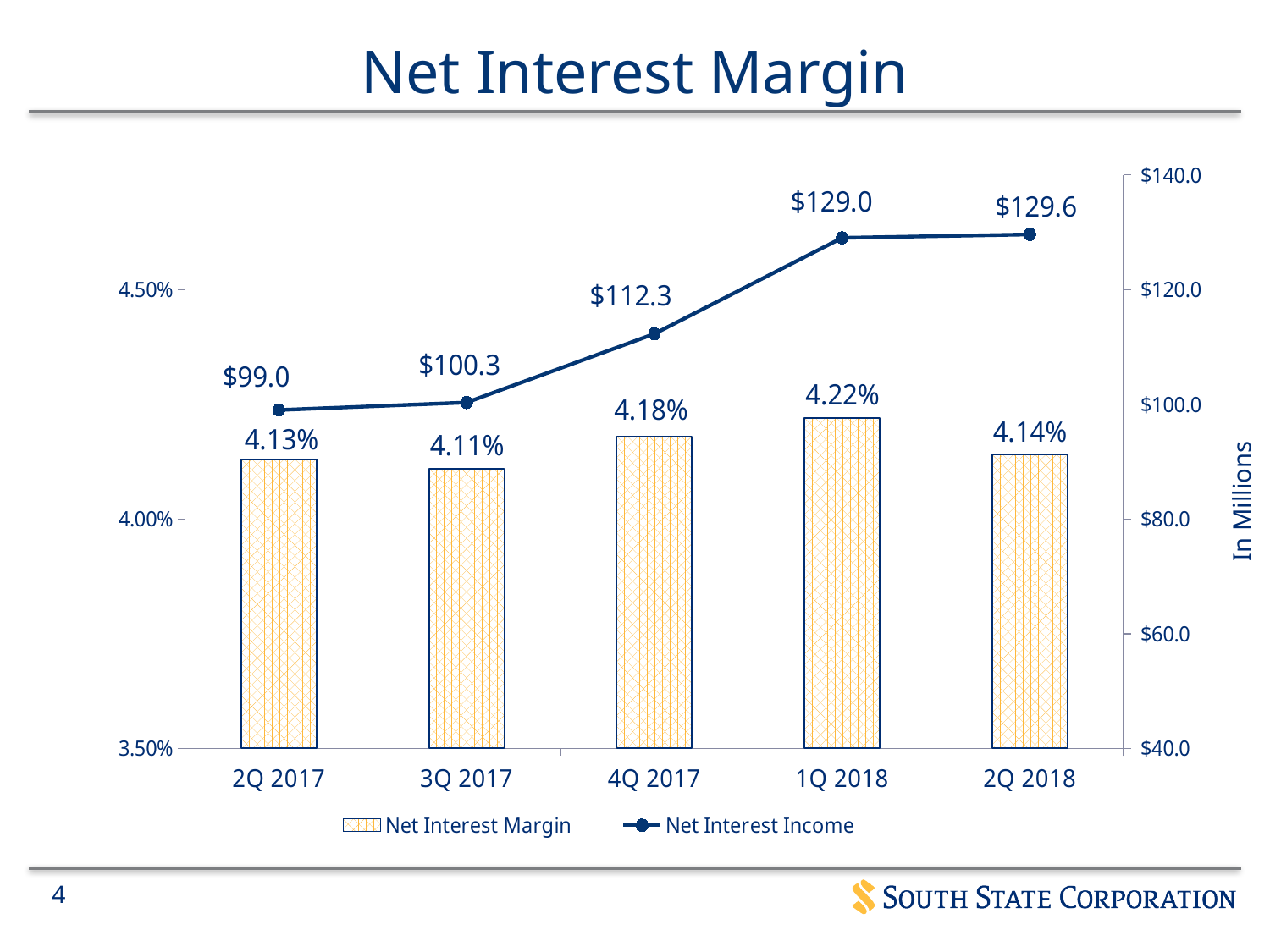
Does Net Interest Income rise or fall from 2Q 2017 to 2Q 2018? rise What is the title of the chart? Net Interest Margin Which quarter has the highest Net Interest Margin? 1Q 2018 What unit label is shown on the right-hand axis? In Millions How many quarters are shown on the x axis? 5 What is the Net Interest Margin for 4Q 2017? 4.18% What is the Net Interest Income for 1Q 2018? $129.0 What is the Net Interest Income for 2Q 2017? $99.0 Which quarter has the lowest Net Interest Income? 2Q 2017 What is the difference in Net Interest Income between 1Q 2018 and 4Q 2017? $16.7 How many series does the legend list? 2 Which is larger, the Net Interest Margin for 2Q 2017 or for 3Q 2017? 2Q 2017